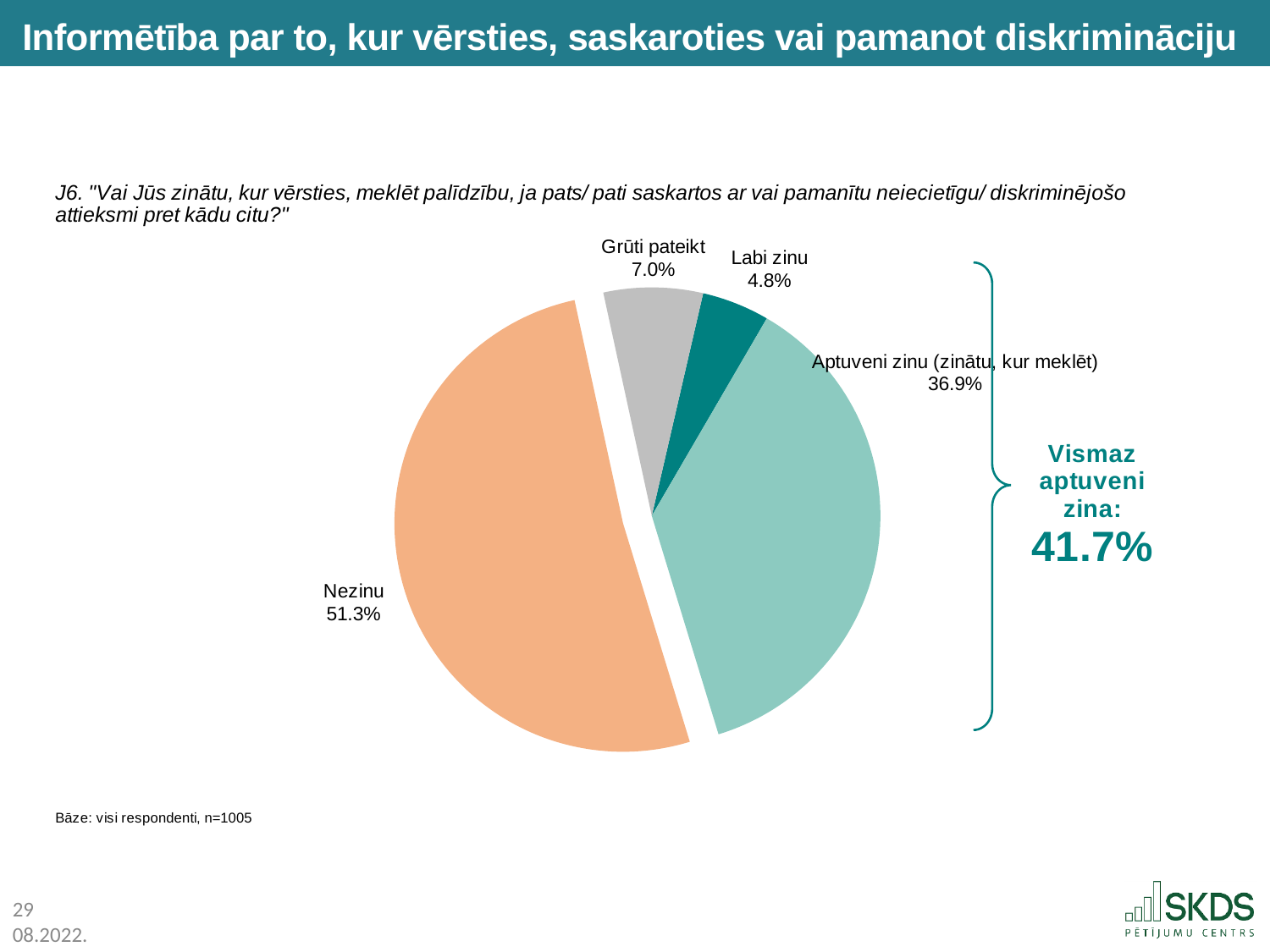
What share of respondents answered "Nezinu"? 51.3% What combined percentage is given on the slide for "Vismaz aptuveni zina"? 41.7% Which answer category has the largest slice of the pie? Nezinu What share of respondents answered "Labi zinu"? 4.8% What is the base (number of respondents) stated below the chart? n=1005 Which answer category has the smallest slice of the pie? Labi zinu What share of respondents answered "Grūti pateikt"? 7.0% What kind of chart is shown on the slide? pie chart What share of respondents answered "Aptuveni zinu (zinātu, kur meklēt)"? 36.9% How many slices does the pie chart have? 4 Which is larger, the share for "Grūti pateikt" or the share for "Labi zinu"? Grūti pateikt What is the difference in percentage points between "Nezinu" and "Aptuveni zinu (zinātu, kur meklēt)"? 14.4